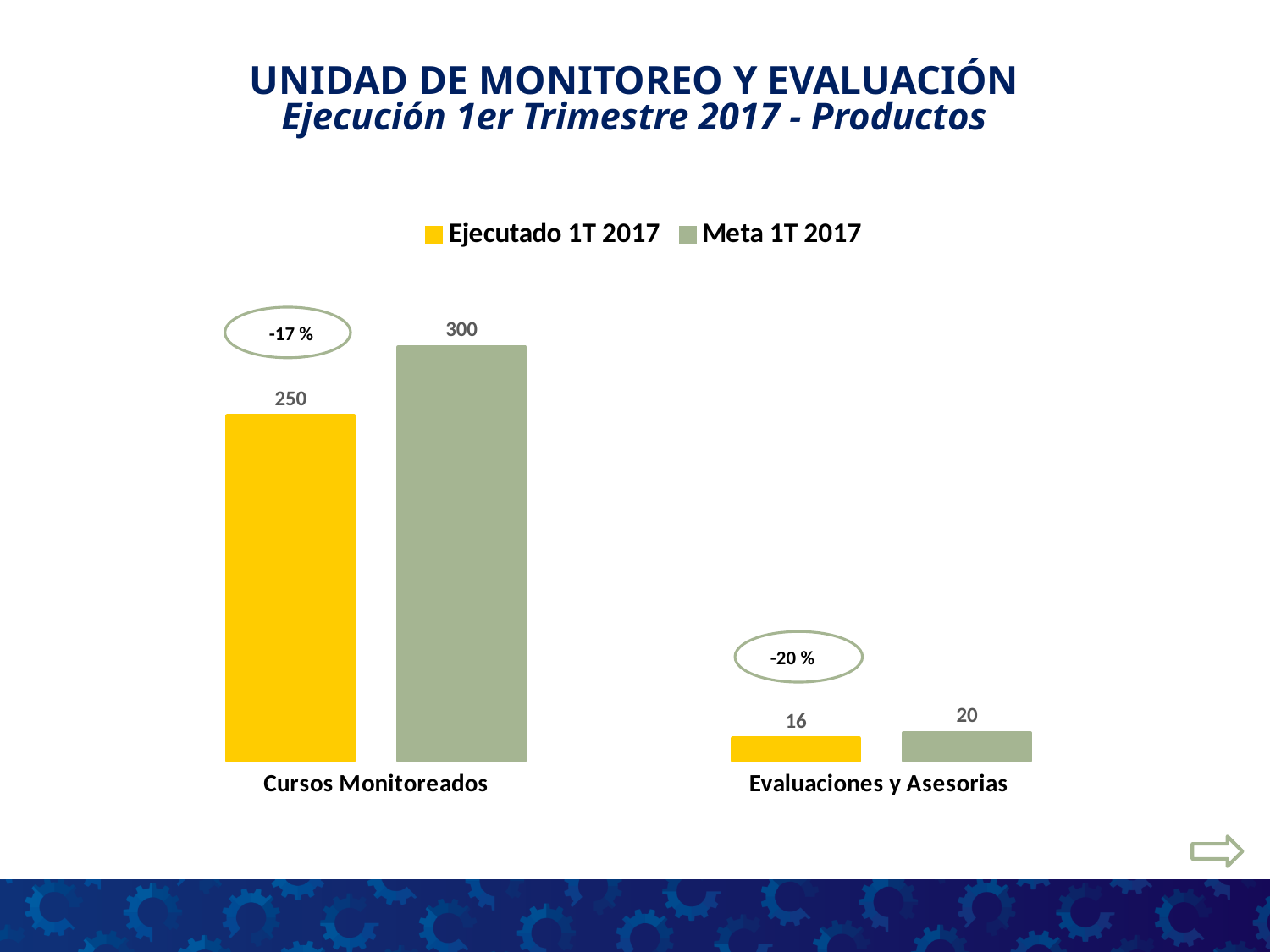
What is the Meta 1T 2017 value for Cursos Monitoreados? 300 What is the difference between the Meta 1T 2017 and Ejecutado 1T 2017 values for Evaluaciones y Asesorias? 4 How many series does the legend list? 2 Which category has the lowest Ejecutado 1T 2017 value? Evaluaciones y Asesorias What is the Ejecutado 1T 2017 value for Evaluaciones y Asesorias? 16 Which is larger for Cursos Monitoreados, the Ejecutado 1T 2017 value or the Meta 1T 2017 value? Meta 1T 2017 Which category has the highest Meta 1T 2017 value? Cursos Monitoreados What is the difference between the Meta 1T 2017 and Ejecutado 1T 2017 values for Cursos Monitoreados? 50 What kind of chart is shown on the slide? Bar chart What is the Ejecutado 1T 2017 value for Cursos Monitoreados? 250 What is the Meta 1T 2017 value for Evaluaciones y Asesorias? 20 How many categories are shown on the x axis of the chart? 2